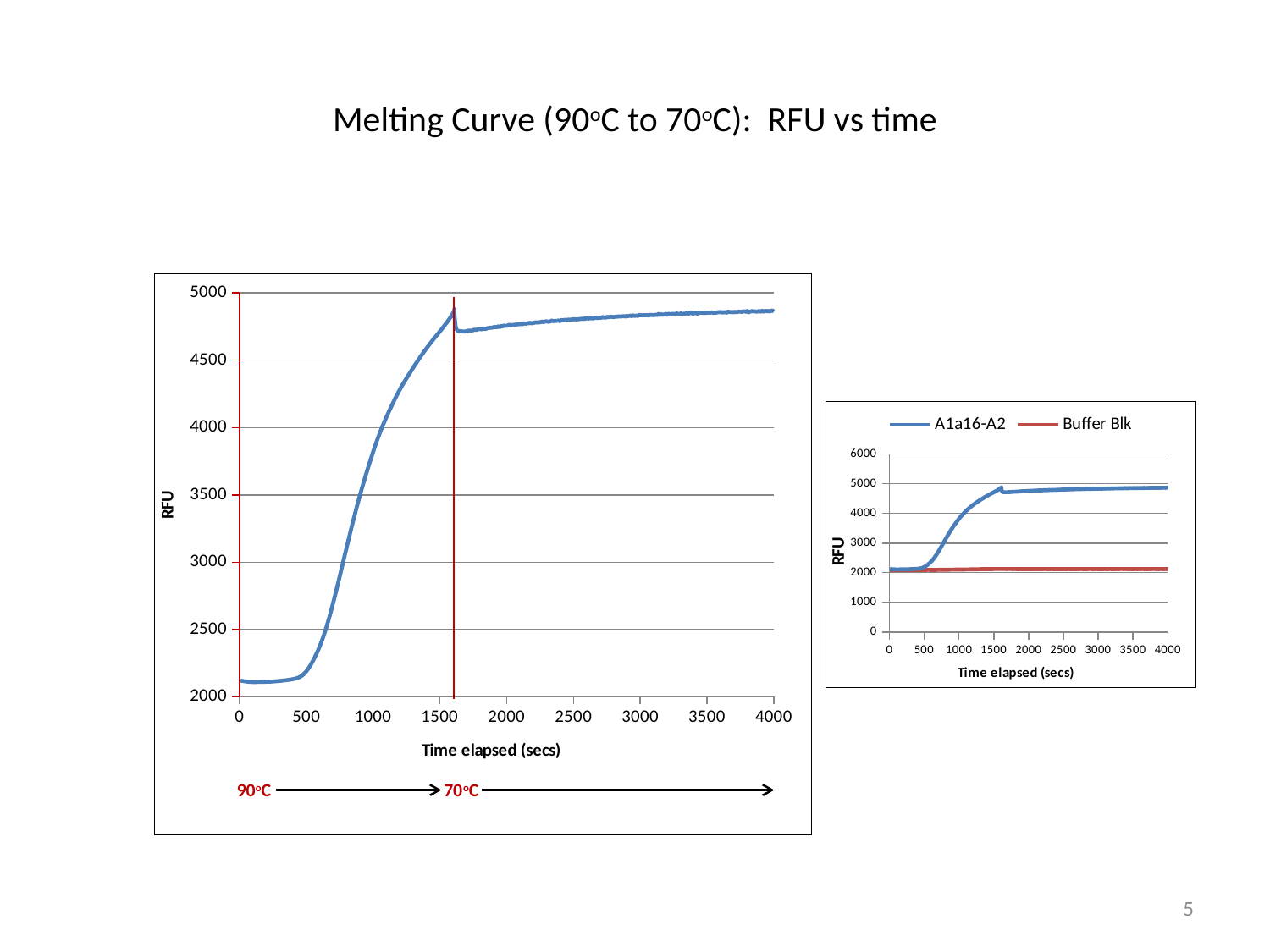
In the large chart on the left, what is the label of the x axis? Time elapsed (secs) How many series does the legend of the small chart on the right list? 2 In the large chart on the left, is the RFU value at 4000 secs greater or less than 4500? greater In the large chart on the left, does the RFU value rise or fall as time elapsed increases from 0 to 4000 secs? rise In the small chart on the right, is the RFU value of Buffer Blk at 2000 secs greater or less than 3000? less In the large chart on the left, is the RFU value at 2000 secs greater or less than 4500? greater What kind of chart is the large chart on the left of the slide? line chart In the small chart on the right, which series has the higher RFU value at 3000 secs, A1a16-A2 or Buffer Blk? A1a16-A2 In the large chart on the left, what is the label of the y axis? RFU